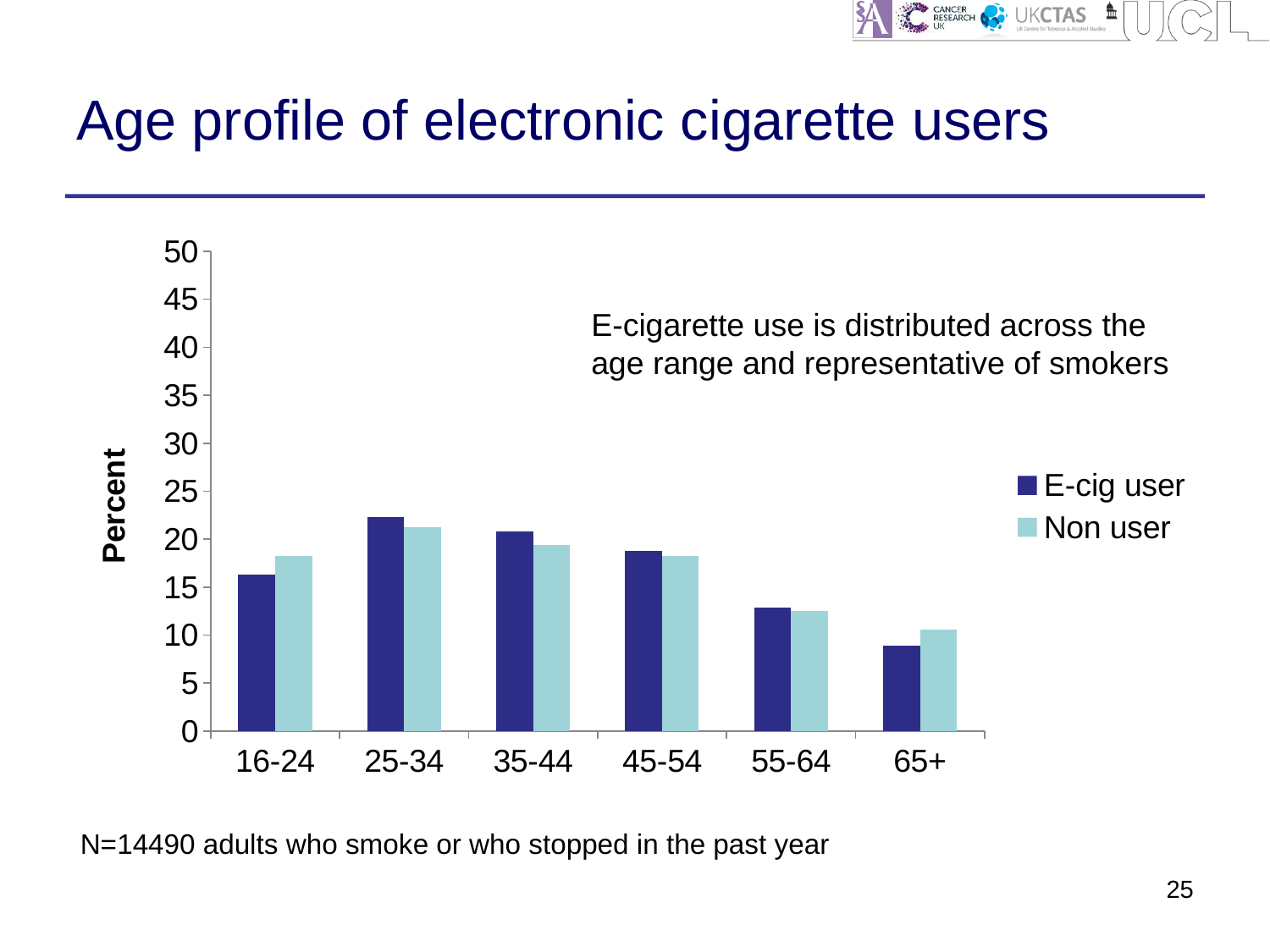
Is the E-cig user value for 25-34 greater or less than 20? greater For the 16-24 age group, which is larger: E-cig user or Non user? Non user Is the E-cig user value for 55-64 greater or less than 15? less Which age group has the lowest value for Non user? 65+ For the 35-44 age group, which is larger: E-cig user or Non user? E-cig user Which age group has the lowest value for E-cig user? 65+ What is the label on the y axis of the chart? Percent How many age groups are shown on the x axis of the chart? 6 How many series does the chart's legend list? 2 Is the E-cig user value for 16-24 greater or less than 20? less What kind of chart is shown on the slide? bar chart Which age group has the highest value for E-cig user? 25-34